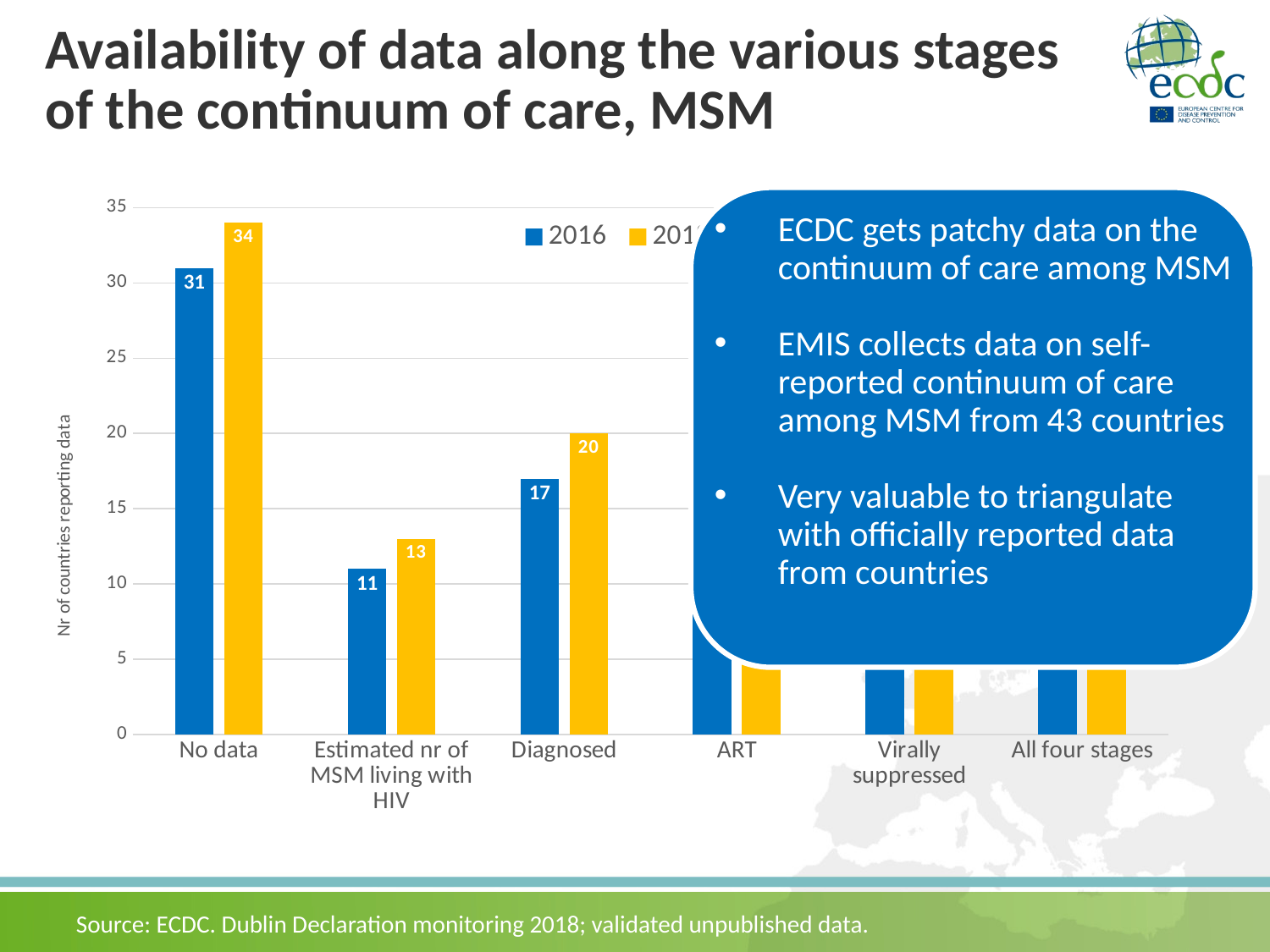
What kind of chart is shown on the slide? bar chart What is the value of the yellow bar for 'No data'? 34 How many countries reported data in 2016 for the 'No data' category? 31 What is the value of the yellow bar for 'Estimated nr of MSM living with HIV'? 13 Is the 2016 value for 'No data' greater or less than 30? greater Which is larger: the 2016 value for 'Diagnosed' or the 2016 value for 'Estimated nr of MSM living with HIV'? Diagnosed Which category has the highest 2016 value? No data How many series does the legend list? 2 What is the 2016 value for 'Diagnosed'? 17 What is the difference between the yellow bar and the 2016 bar for 'No data'? 3 What is the difference between the yellow bar and the 2016 bar for 'Diagnosed'? 3 How many categories are shown on the x axis? 6